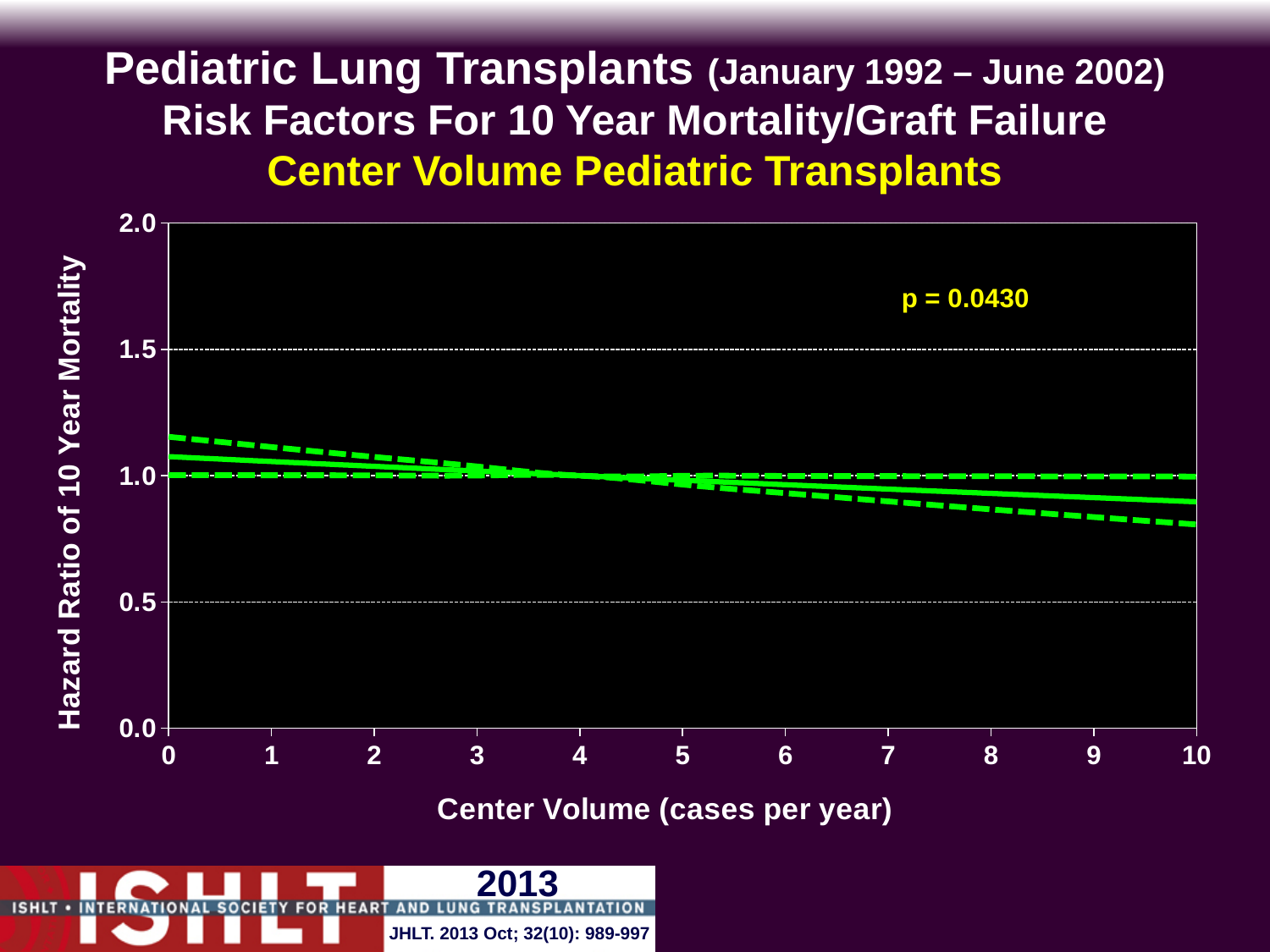
Does the solid hazard ratio line rise or fall as center volume increases from 0 to 10 cases per year? fall Is the hazard ratio shown by the solid line at a center volume of 0 cases per year greater or less than 1.5? less What is the title of the x axis of the chart? Center Volume (cases per year) What p-value is printed on the chart? p = 0.0430 Is the hazard ratio shown by the solid line at a center volume of 10 cases per year greater or less than 0.5? greater How many tick labels are shown on the x axis of the chart? 11 What kind of chart is shown on the slide? line chart Is the hazard ratio shown by the solid line at a center volume of 10 cases per year greater or less than 1.5? less How many lines are plotted on the chart? 3